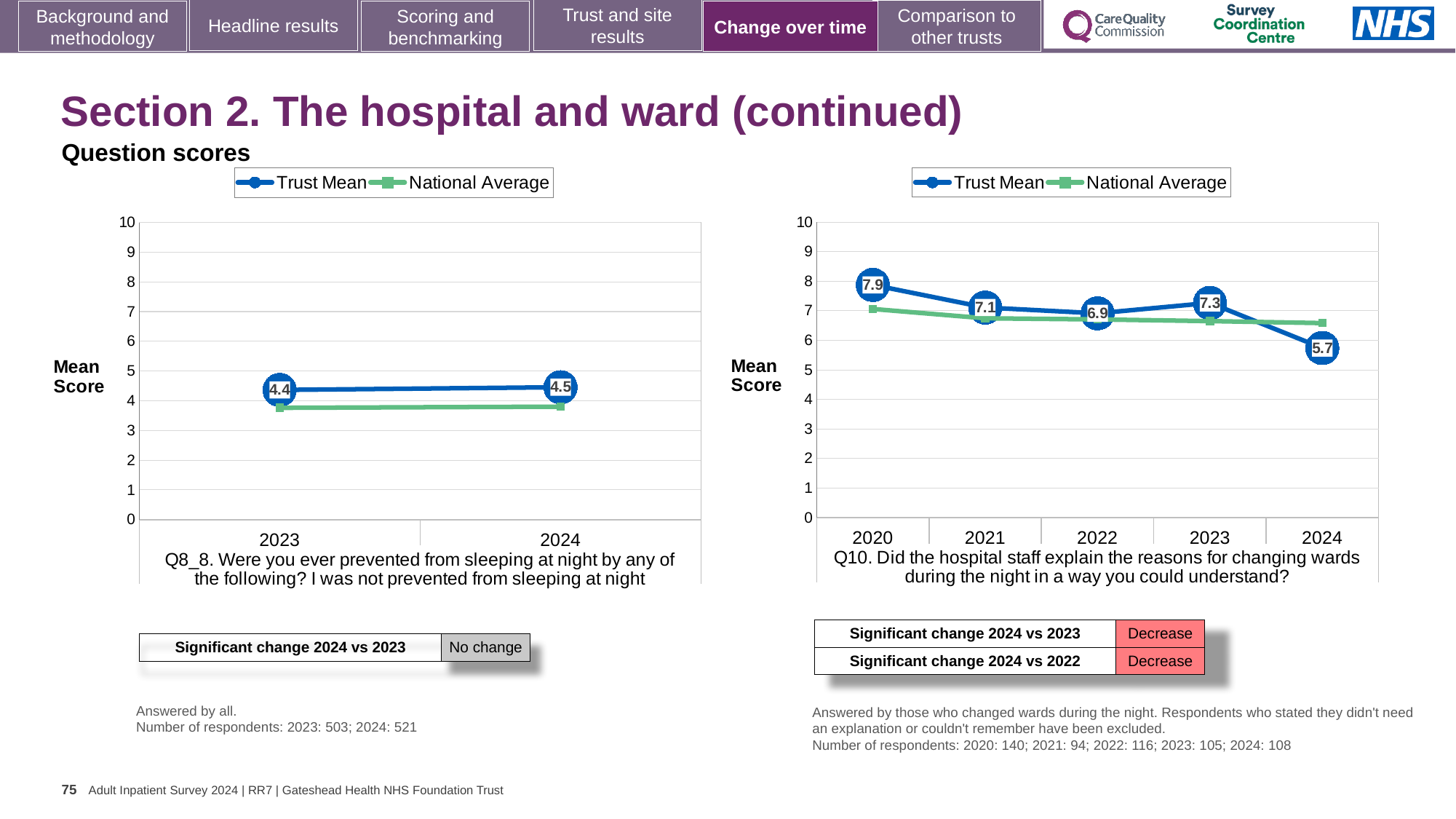
In the left chart (Q8_8), what is the Trust Mean score for 2023? 4.4 In the left chart (Q8_8), what is the Trust Mean score for 2024? 4.5 In the right chart (Q10), is the Trust Mean score for 2022 or 2023 larger? 2023 What kind of chart is the right chart (Q10)? Line chart In the right chart (Q10), which year has the lowest Trust Mean score? 2024 In the left chart (Q8_8), is the National Average for 2024 greater or less than 4? less In the right chart (Q10), what is the Trust Mean score for 2024? 5.7 In the right chart (Q10), which year has the highest Trust Mean score? 2020 How many years are plotted on the x axis of the right chart (Q10)? 5 In the right chart (Q10), what is the difference between the Trust Mean scores for 2023 and 2024? 1.6 In the right chart (Q10), what is the Trust Mean score for 2020? 7.9 How many series does the legend of the left chart (Q8_8) list? 2